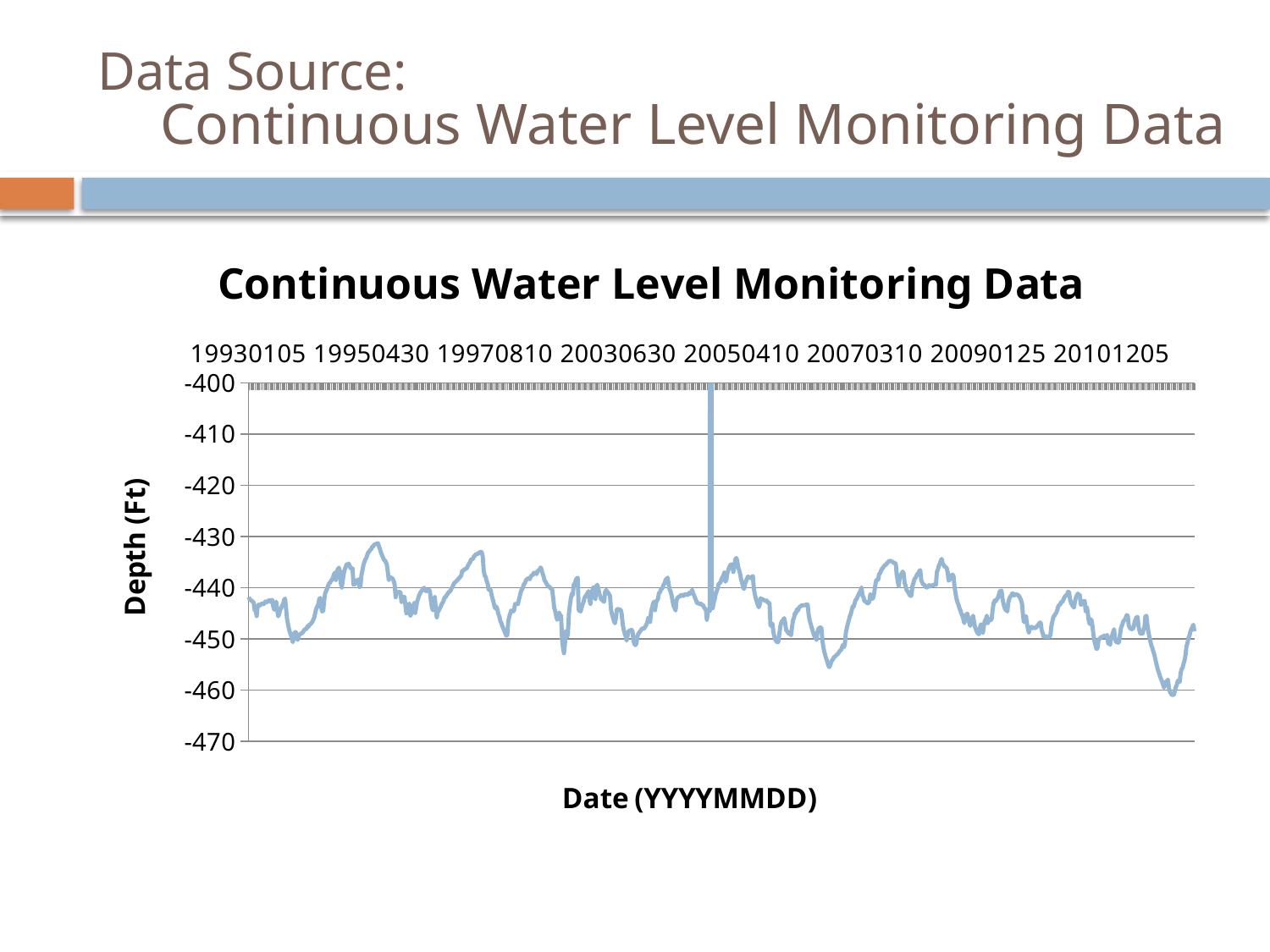
Is the depth value at 20090125 greater or less than -470? greater Is the depth value at 19930105 greater or less than -430? less Is the peak of the tall vertical spike near 20050410 greater or less than -410? greater What is the label on the vertical axis of the chart? Depth (Ft) What kind of chart is shown on the slide? line chart How many date labels are shown along the x axis of the chart? 8 What is the title of the chart? Continuous Water Level Monitoring Data